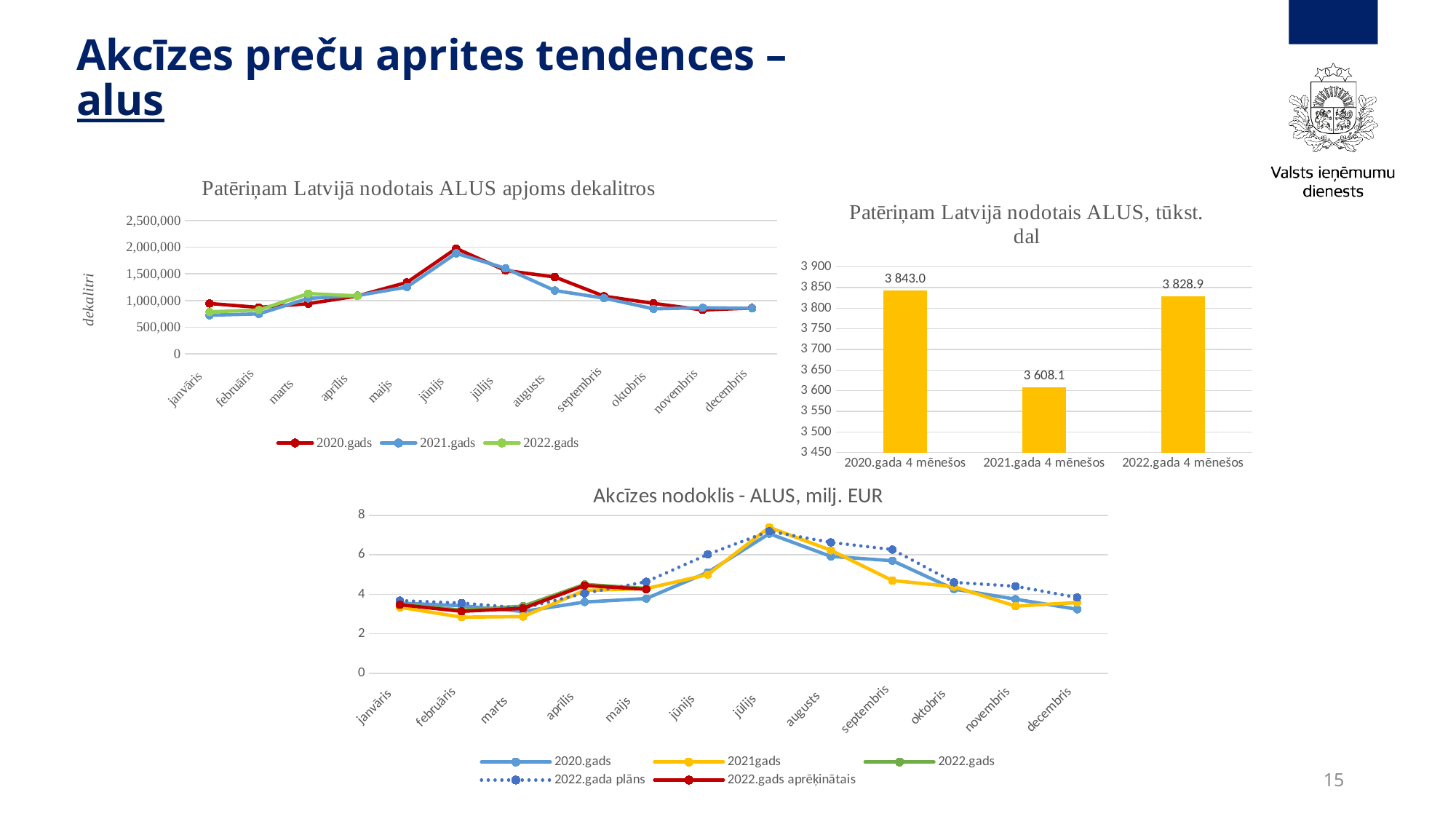
How many months are shown on the x axis of the chart 'Patēriņam Latvijā nodotais ALUS apjoms dekalitros'? 12 How many series does the legend of the chart 'Akcīzes nodoklis - ALUS, milj. EUR' list? 5 In the chart 'Patēriņam Latvijā nodotais ALUS, tūkst. dal', what is the value for 2021.gada 4 mēnešos? 3 608.1 In the chart 'Patēriņam Latvijā nodotais ALUS, tūkst. dal', what is the difference between the values for 2020.gada 4 mēnešos and 2021.gada 4 mēnešos? 234.9 In the chart 'Patēriņam Latvijā nodotais ALUS, tūkst. dal', which category has the lowest value? 2021.gada 4 mēnešos In the chart 'Patēriņam Latvijā nodotais ALUS, tūkst. dal', what is the value for 2020.gada 4 mēnešos? 3 843.0 In the chart 'Patēriņam Latvijā nodotais ALUS, tūkst. dal', what is the value for 2022.gada 4 mēnešos? 3 828.9 In the chart 'Patēriņam Latvijā nodotais ALUS, tūkst. dal', which category has the highest value? 2020.gada 4 mēnešos How many series does the legend of the chart 'Patēriņam Latvijā nodotais ALUS apjoms dekalitros' list? 3 In the chart 'Akcīzes nodoklis - ALUS, milj. EUR', is the value for 2022.gada plāns in jūnijs greater or less than 4? greater What kind of chart is 'Patēriņam Latvijā nodotais ALUS, tūkst. dal'? bar chart In the chart 'Patēriņam Latvijā nodotais ALUS apjoms dekalitros', is the value for 2020.gads in jūnijs greater or less than 1,500,000? greater